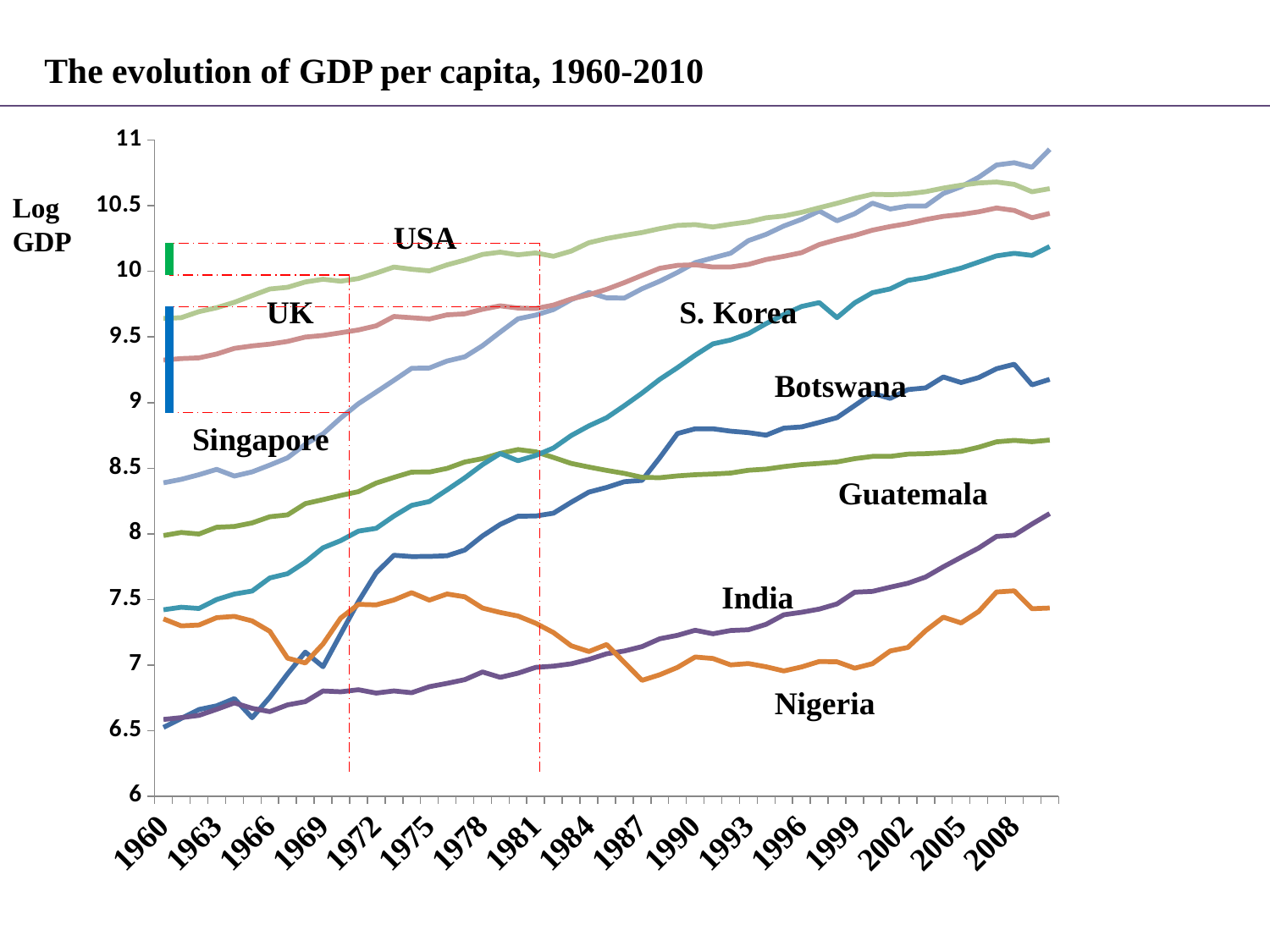
What kind of chart is shown on the slide? line chart Is the value for Singapore in 1960 greater or less than 9? less Which country has the lowest log GDP per capita at the end of the period (2010)? Nigeria Is the value for S. Korea in 2010 greater or less than 10? greater Which country has the highest log GDP per capita in 1960? USA Is the value for Nigeria in 2010 greater or less than 8? less Does the line for India rise or fall over the period 1960-2010? rise Which country has the highest log GDP per capita at the end of the period (2010)? Singapore What is the title of the chart? The evolution of GDP per capita, 1960-2010 How many countries are plotted on the chart? 8 What is the label on the vertical axis? Log GDP In 2010, which is higher: Botswana or Guatemala? Botswana